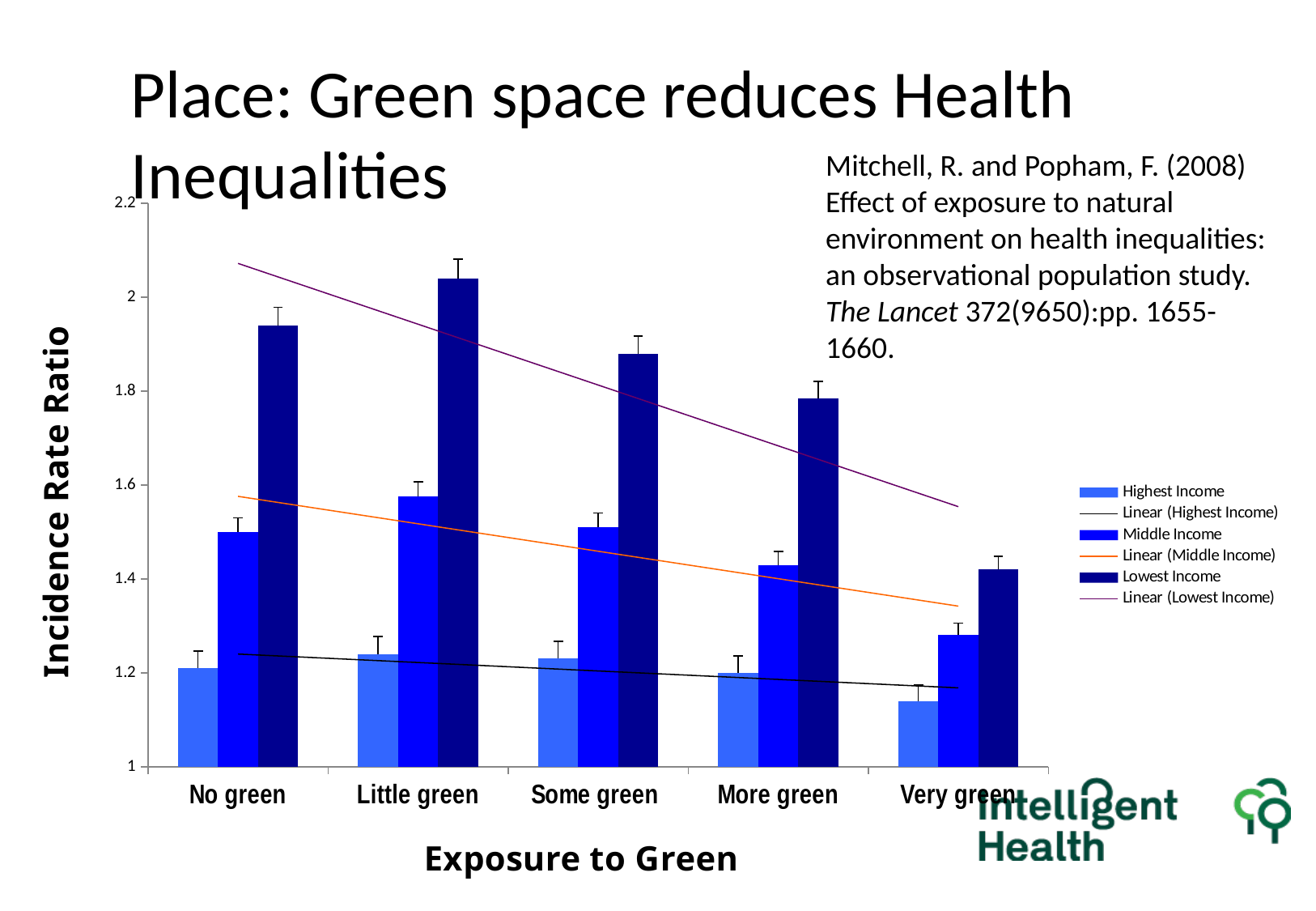
How many entries does the chart legend list? 6 What is the label of the x axis? Exposure to Green How many exposure-to-green categories are shown on the x axis? 5 For which exposure category is the Highest Income bar the shortest? Very green For which exposure category is the Lowest Income bar the shortest? Very green What is the label of the y axis? Incidence Rate Ratio For which exposure category is the Lowest Income bar the tallest? Little green Is the Lowest Income value for No green greater or less than 2? less At No green, which is larger: the Lowest Income bar or the Highest Income bar? Lowest Income What kind of chart is shown on the slide? bar chart Is the Lowest Income value for Some green greater or less than 1.8? greater Is the Middle Income value for Very green greater or less than 1.4? less